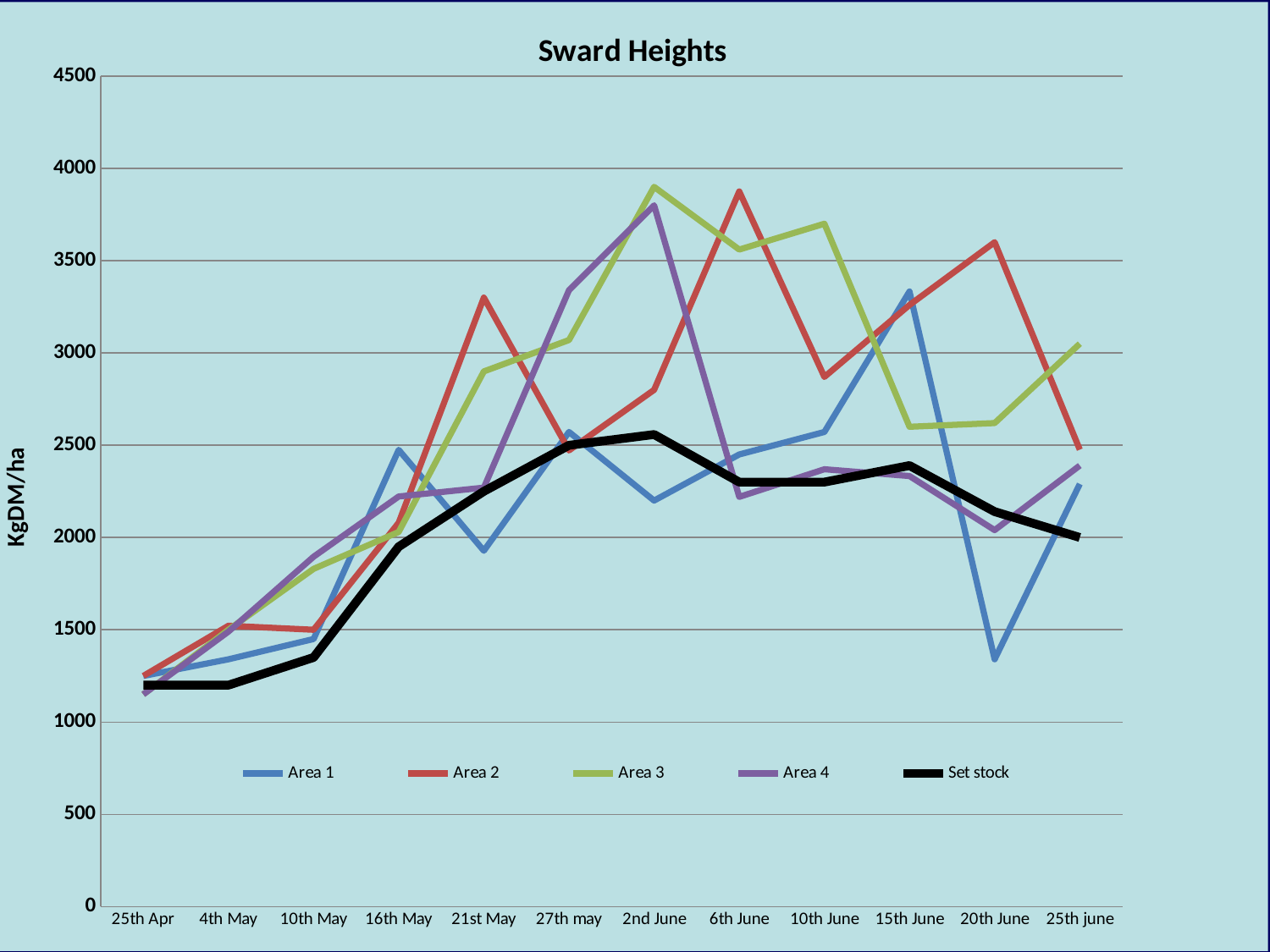
Is the value for Area 1 on 20th June greater or less than 1500? less Which series has the lowest value on 20th June? Area 1 How many series does the legend list? 5 What kind of chart is shown on the slide? line chart What is the title of the chart? Sward Heights Which series has the highest value on 6th June? Area 2 Is the value for Set stock on 25th Apr greater or less than 1500? less Is the value for Area 3 on 2nd June greater or less than 3500? greater On 10th June, which is larger: Area 3 or Set stock? Area 3 What is the label on the vertical axis? KgDM/ha Does the Set stock line rise or fall from 25th Apr to 2nd June? rise How many dates are shown along the x axis? 12